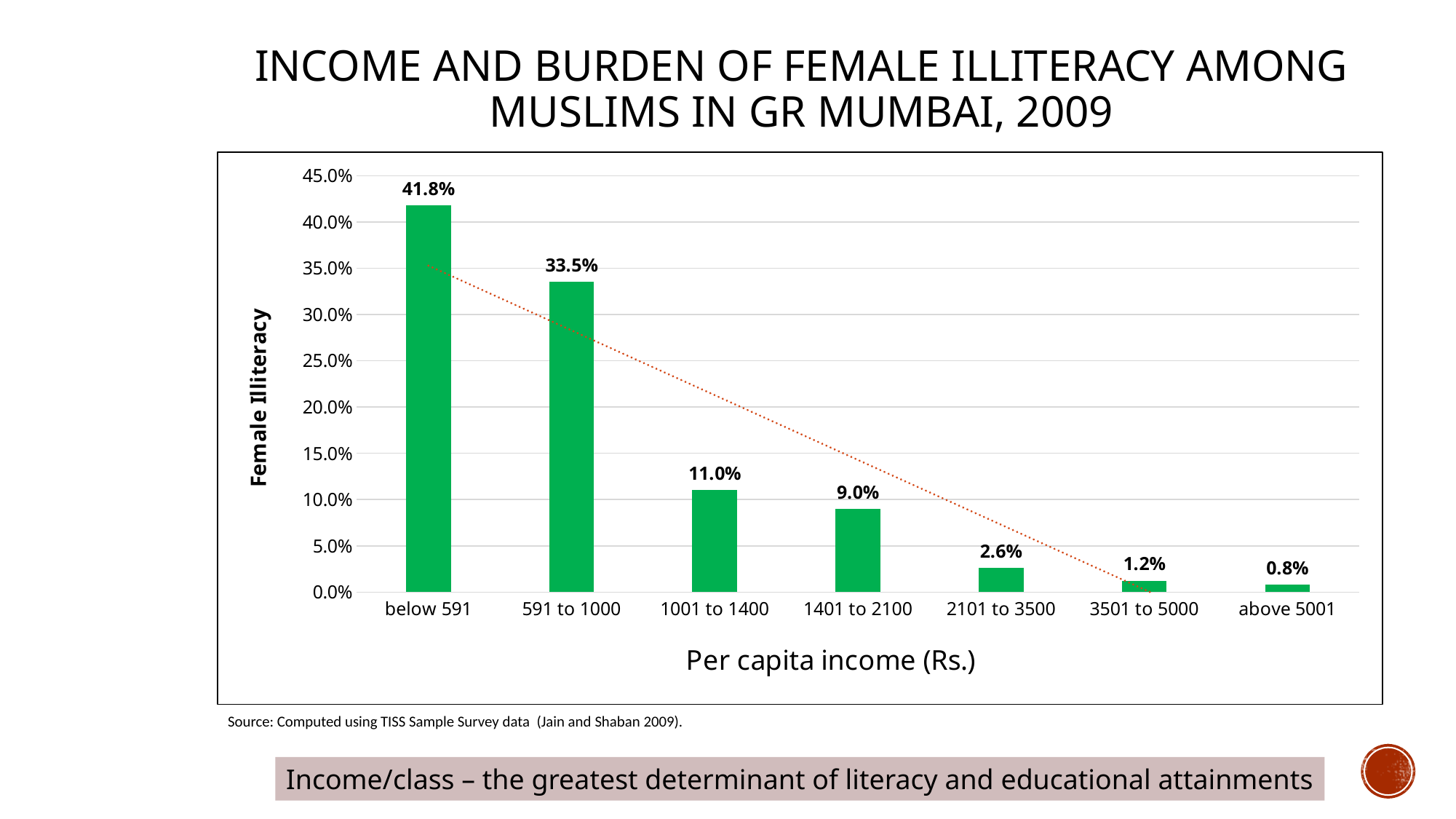
What is the female illiteracy rate for the '1001 to 1400' income group? 11.0% Which income group has the lowest female illiteracy rate? above 5001 Which has a higher female illiteracy rate: '1001 to 1400' or '1401 to 2100'? 1001 to 1400 How many income groups are shown on the x axis? 7 Does female illiteracy rise or fall as per capita income increases along the x axis? Fall What is the female illiteracy rate for the 'below 591' income group? 41.8% Which income group has the highest female illiteracy rate? below 591 Is the female illiteracy rate for '591 to 1000' greater or less than 30.0%? greater What kind of chart is shown on the slide? Bar chart What is the difference in female illiteracy between the '1401 to 2100' and '2101 to 3500' groups? 6.4% What is the female illiteracy rate for the 'above 5001' income group? 0.8% What is the difference in female illiteracy between the 'below 591' and '591 to 1000' groups? 8.3%